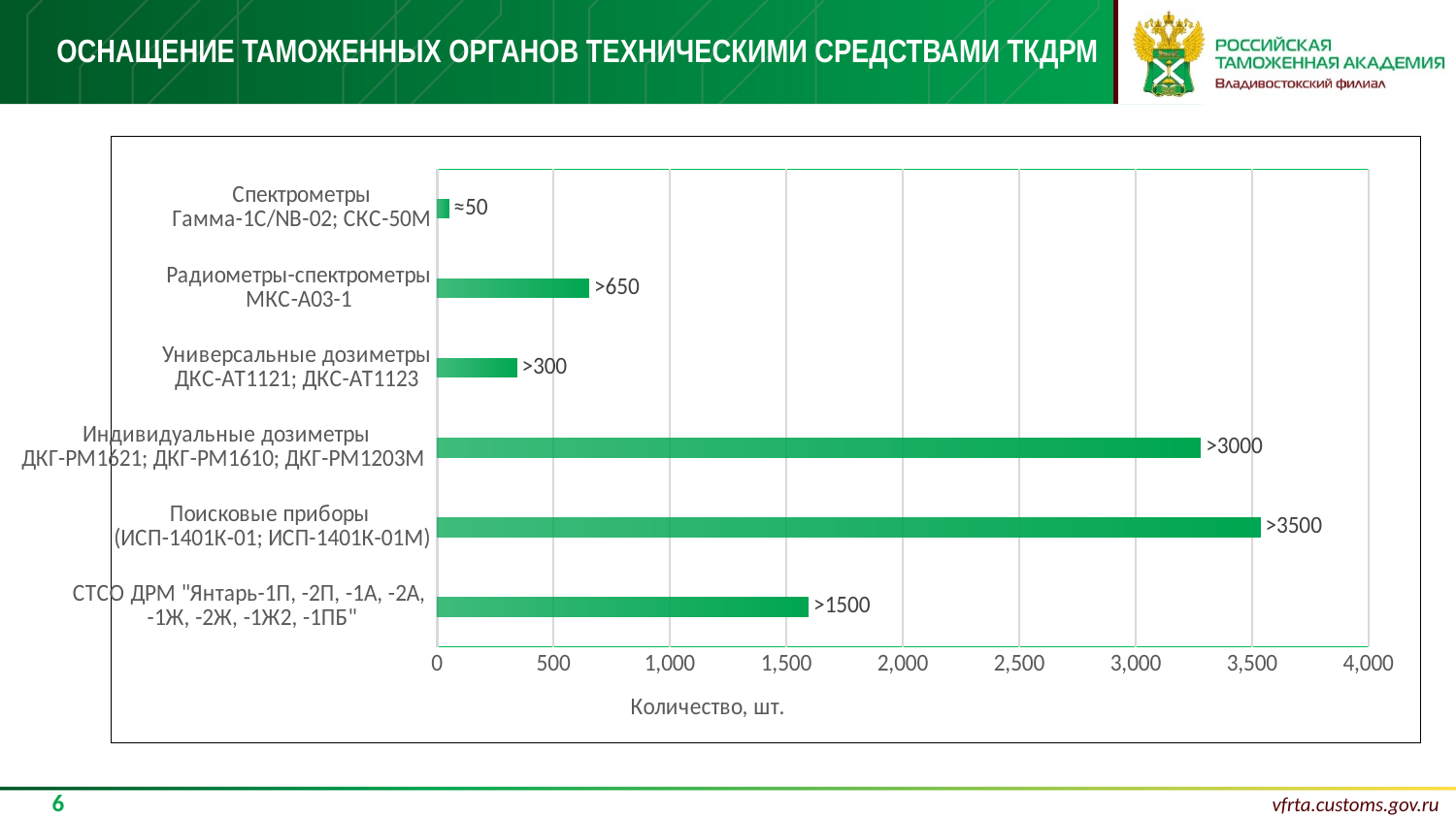
Is the value for Поисковые приборы greater or less than 3,000? greater What kind of chart is shown on the slide? bar chart What data label is shown for СТСО ДРМ "Янтарь-1П, -2П, -1А, -2А, -1Ж, -2Ж, -1Ж2, -1ПБ"? >1500 Which category has the shortest bar in the chart? Спектрометры Гамма-1С/NB-02; СКС-50М Which category has the longest bar in the chart? Поисковые приборы (ИСП-1401К-01; ИСП-1401К-01М) What data label is shown for Индивидуальные дозиметры ДКГ-РМ1621; ДКГ-РМ1610; ДКГ-РМ1203М? >3000 Is the value for Радиометры-спектрометры МКС-А03-1 greater or less than 500? greater What data label is shown for Универсальные дозиметры ДКС-АТ1121; ДКС-АТ1123? >300 Which is larger: the value for Индивидуальные дозиметры or the value for СТСО ДРМ "Янтарь"? Индивидуальные дозиметры How many categories (types of equipment) are plotted in the chart? 6 What data label is shown for Радиометры-спектрометры МКС-А03-1? >650 What is the title of the horizontal axis of the chart? Количество, шт.